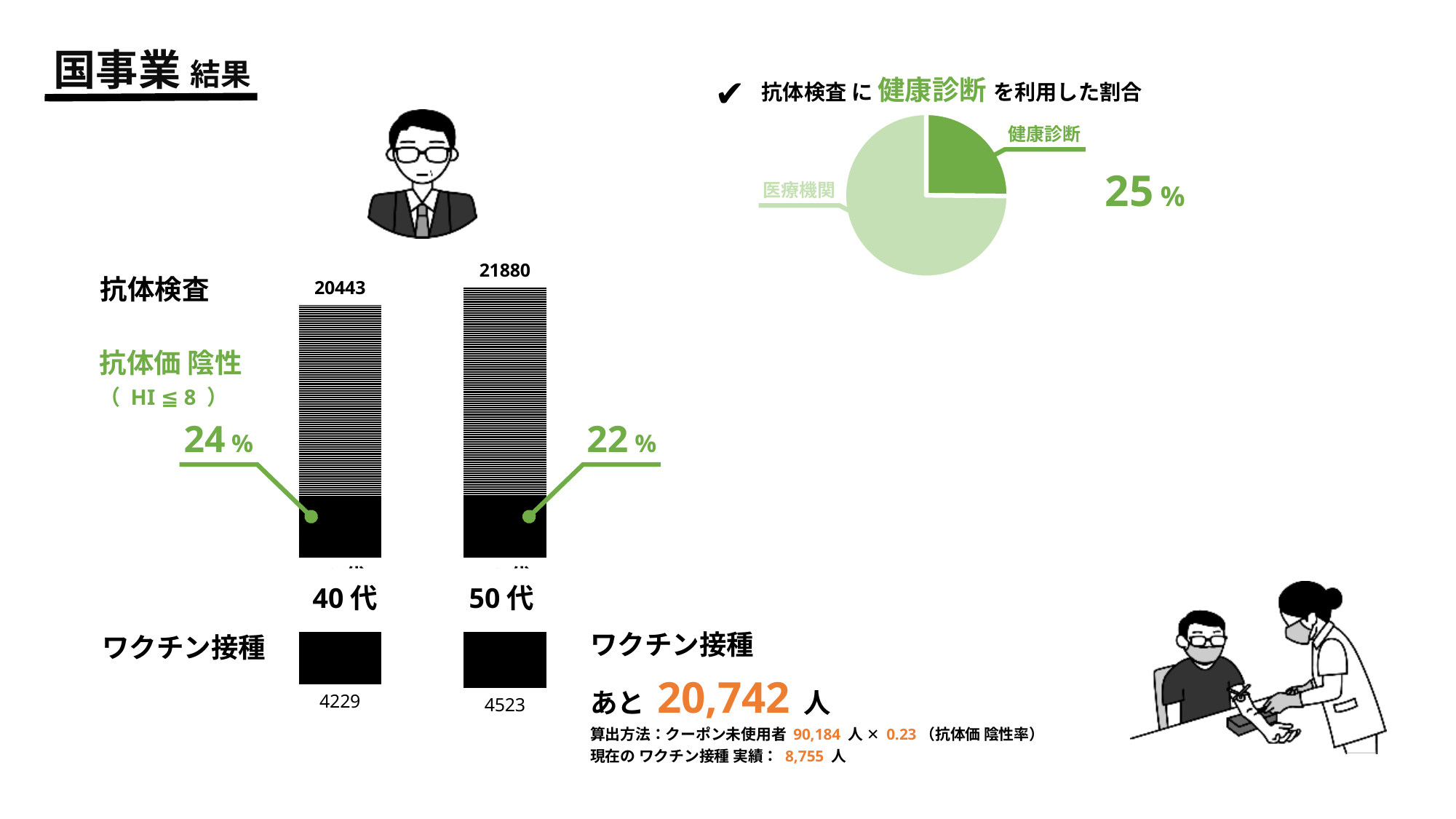
In the bar chart on the left, which age group has the higher 抗体検査 value? 50代 In the bar chart on the left, what percentage of 50代 is labelled 抗体価 陰性 (HI ≦ 8)? 22% What kind of chart is shown on the right of the slide? Pie chart In the bar chart on the left, what is the difference between the 抗体検査 values for 50代 and 40代? 1437 In the bar chart on the left, what is the ワクチン接種 value for 40代? 4229 In the pie chart on the right, what share is labelled 健康診断? 25% In the bar chart on the left, which age group has the lower ワクチン接種 value? 40代 In the bar chart on the left, how many age groups are shown? 2 In the bar chart on the left, what is the 抗体検査 value for 40代? 20443 In the bar chart on the left, what is the ワクチン接種 value for 50代? 4523 In the bar chart on the left, what percentage of 40代 is labelled 抗体価 陰性 (HI ≦ 8)? 24% In the bar chart on the left, what is the 抗体検査 value for 50代? 21880